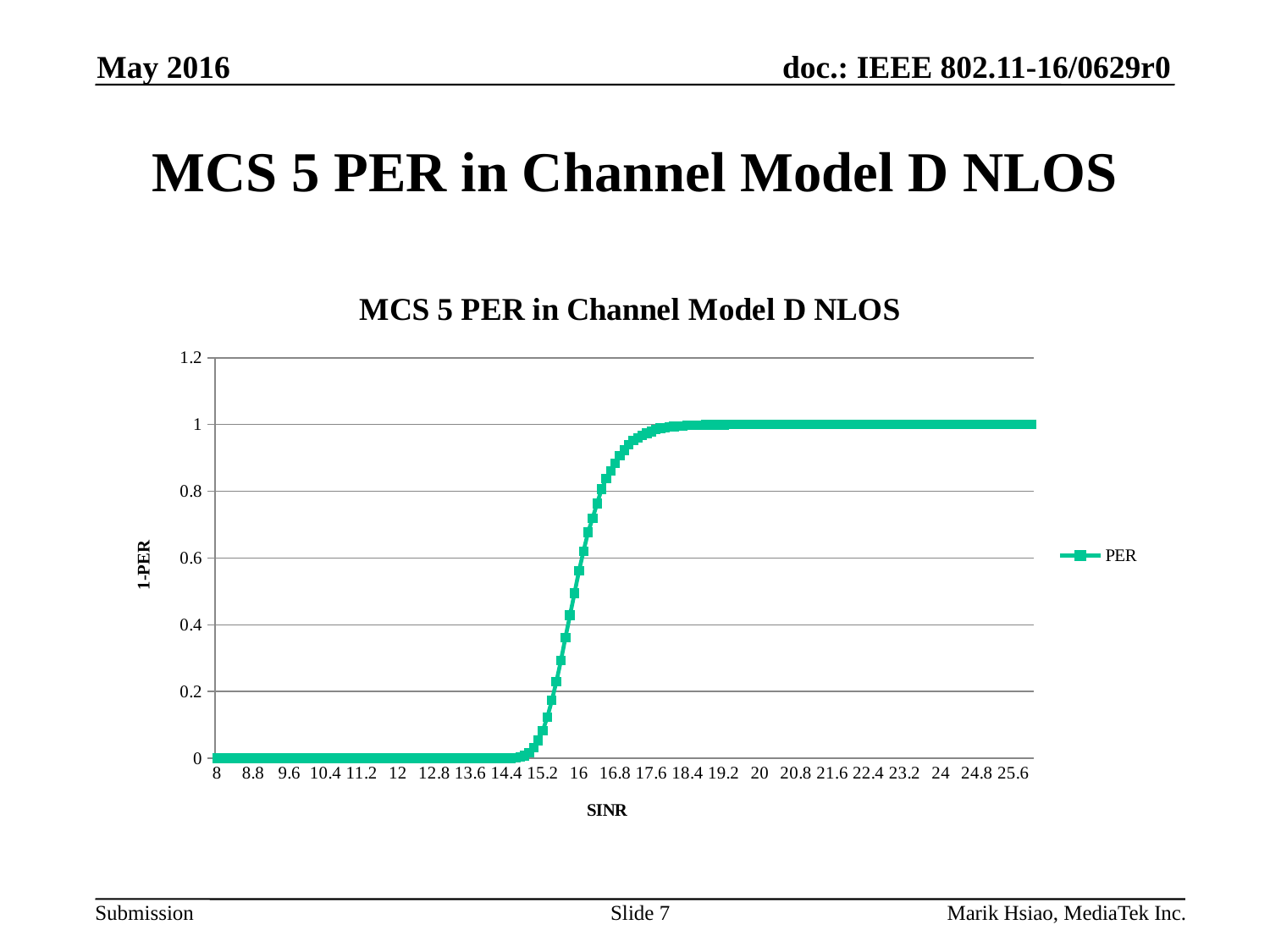
Which has the larger value, SINR 16 or SINR 24? SINR 24 Is the value for SINR 20 greater or less than 0.8? greater Is the value for SINR 25.6 greater or less than 0.8? greater Is the value for SINR 8 greater or less than 0.2? less What is the name of the series shown in the legend? PER Which has the larger value, SINR 12 or SINR 20? SINR 20 Do the values rise or fall as SINR increases along the x axis? rise What kind of chart is shown on the slide? line chart What is the title of the chart? MCS 5 PER in Channel Model D NLOS How many series does the legend list? 1